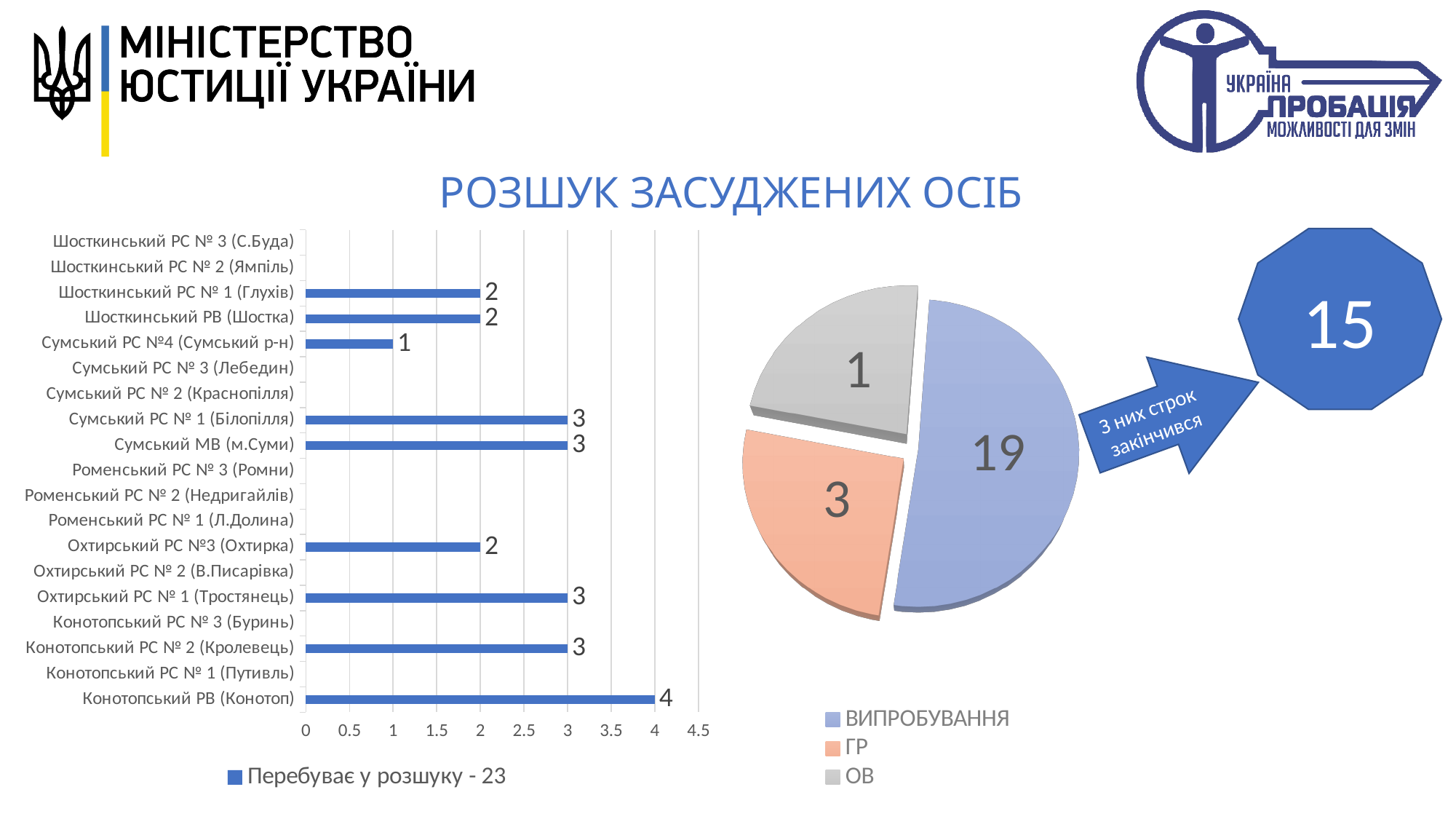
In the pie chart on the right, which category has the smallest slice? ОВ In the pie chart on the right, what is the value for ВИПРОБУВАННЯ? 19 In the bar chart on the left, what is the value for Конотопський РВ (Конотоп)? 4 In the bar chart on the left, what is the value for Сумський РС №4 (Сумський р-н)? 1 In the bar chart on the left, what is the difference between the values for Конотопський РВ (Конотоп) and Охтирський РС №3 (Охтирка)? 2 In the bar chart on the left, which is larger: the value for Сумський МВ (м.Суми) or the value for Шосткинський РВ (Шостка)? Сумський МВ (м.Суми) In the bar chart on the left, which category has the highest value? Конотопський РВ (Конотоп) How many categories are listed on the axis of the bar chart on the left? 19 How many entries does the legend of the pie chart on the right list? 3 In the pie chart on the right, what is the value for ГР? 3 What kind of chart is the chart on the left of the slide? bar chart What is the legend entry of the bar chart on the left? Перебуває у розшуку - 23